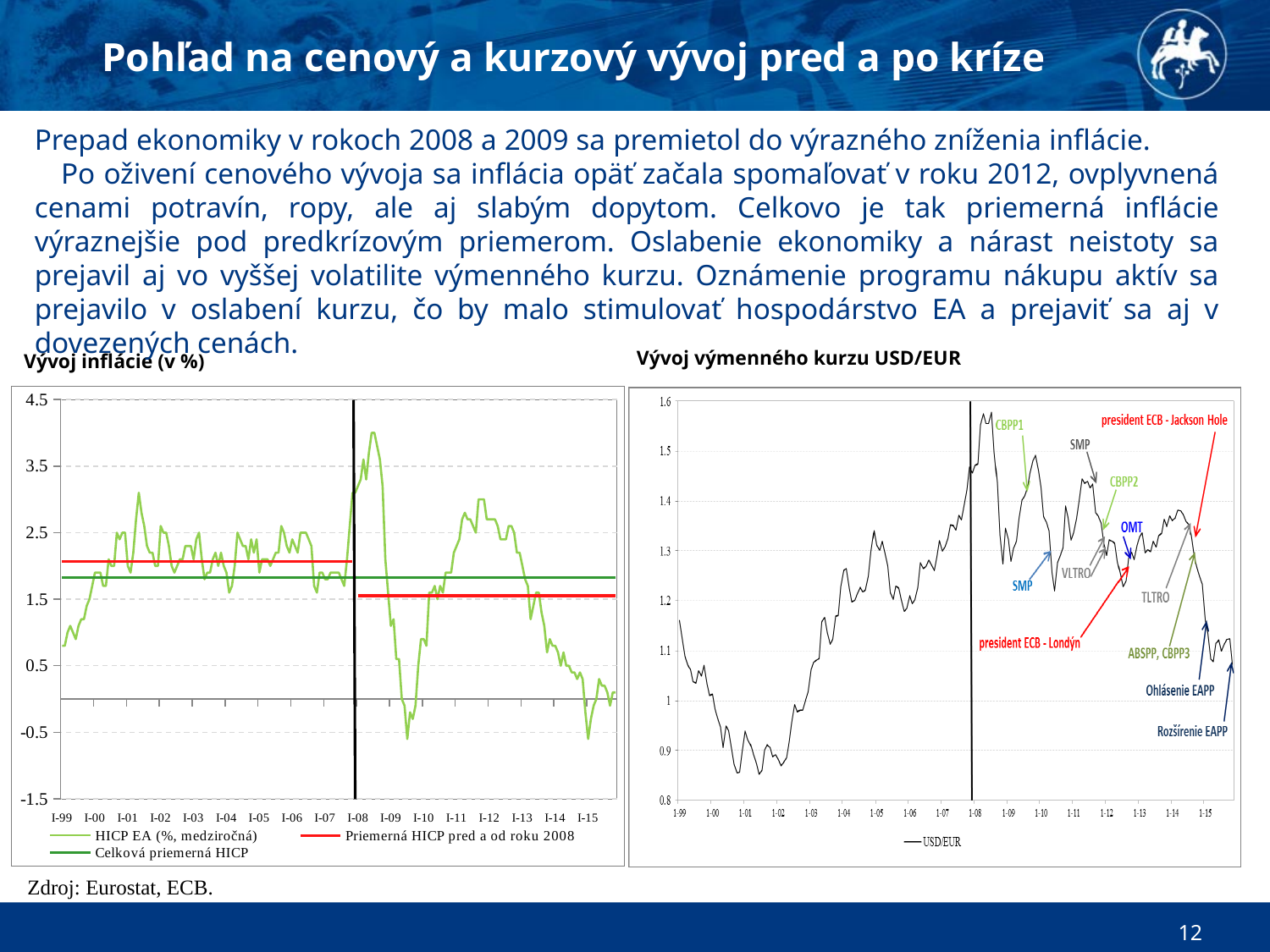
What kind of chart is the 'Vývoj inflácie (v %)' chart on the left? line chart In the 'Vývoj výmenného kurzu USD/EUR' chart, is the peak of USD/EUR in 2008 greater or less than 1.5? greater In the 'Vývoj inflácie (v %)' chart, is the lowest value of HICP EA in 2009 greater or less than 0? less In the 'Vývoj inflácie (v %)' chart, which is higher: the average HICP before 2008 or the average HICP from 2008 onward? before 2008 In the 'Vývoj výmenného kurzu USD/EUR' chart, does the USD/EUR rate rise or fall between 1-01 and 1-08? rise How many series does the legend of the 'Vývoj výmenného kurzu USD/EUR' chart list? 1 In the 'Vývoj výmenného kurzu USD/EUR' chart, is the USD/EUR value at 1-01 greater or less than 1? less What is the highest value shown on the y axis of the 'Vývoj výmenného kurzu USD/EUR' chart? 1.6 What colour is the HICP EA (%, medziročná) line in the 'Vývoj inflácie (v %)' chart? green How many series does the legend of the 'Vývoj inflácie (v %)' chart list? 3